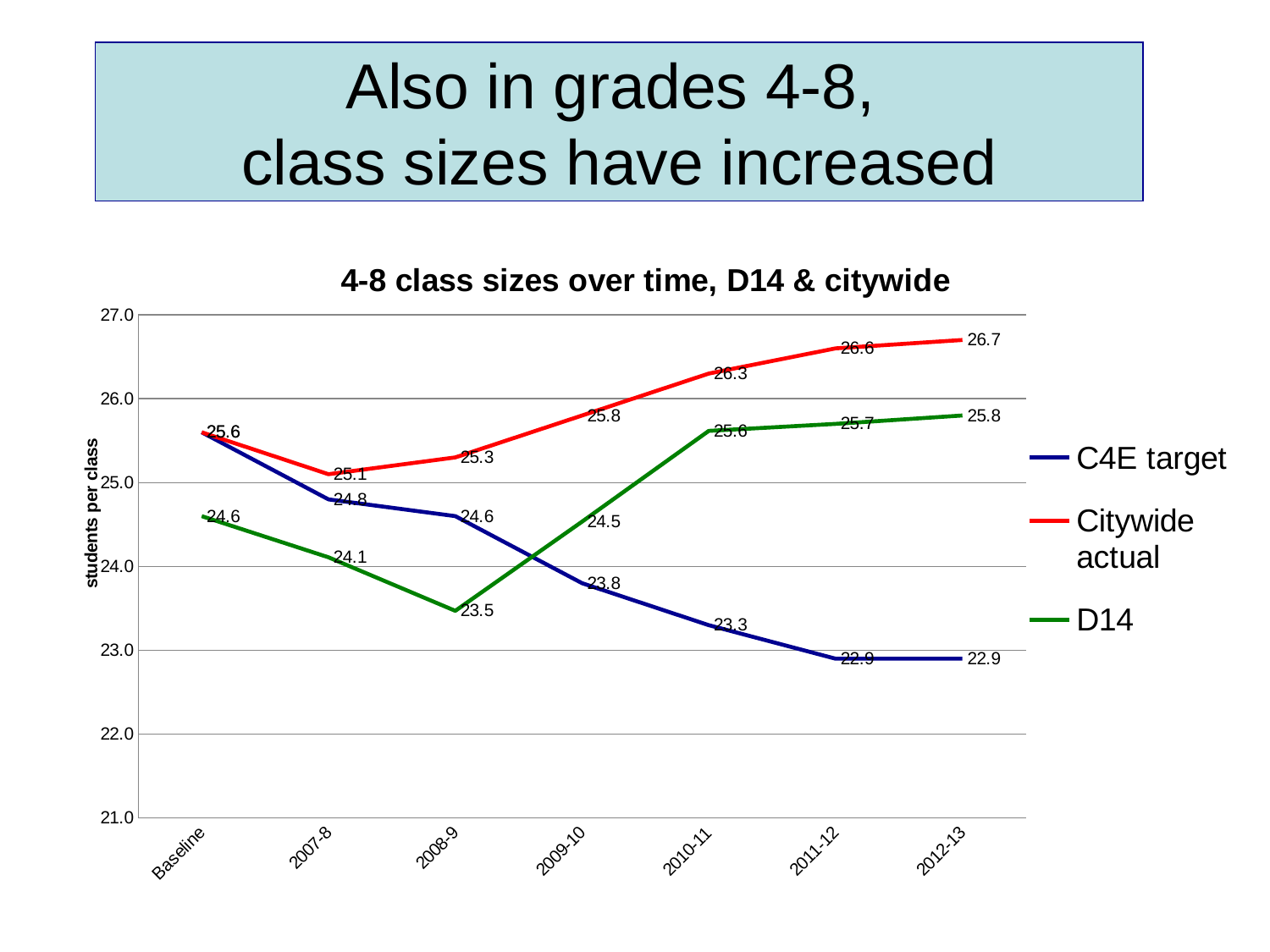
What is the Citywide actual class size in 2012-13? 26.7 In which year is the Citywide actual class size highest? 2012-13 How many series does the legend list? 3 What is the D14 class size in 2008-9? 23.5 What is the label on the vertical axis? students per class In 2010-11, which is larger: the D14 value or the Citywide actual value? Citywide actual What is the C4E target value in 2011-12? 22.9 In which year is the D14 class size lowest? 2008-9 How many time points are plotted along the x axis? 7 What is the difference between the Citywide actual value and the C4E target value in 2012-13? 3.8 Does the C4E target series rise or fall from Baseline to 2012-13? fall What kind of chart is shown on the slide? line chart